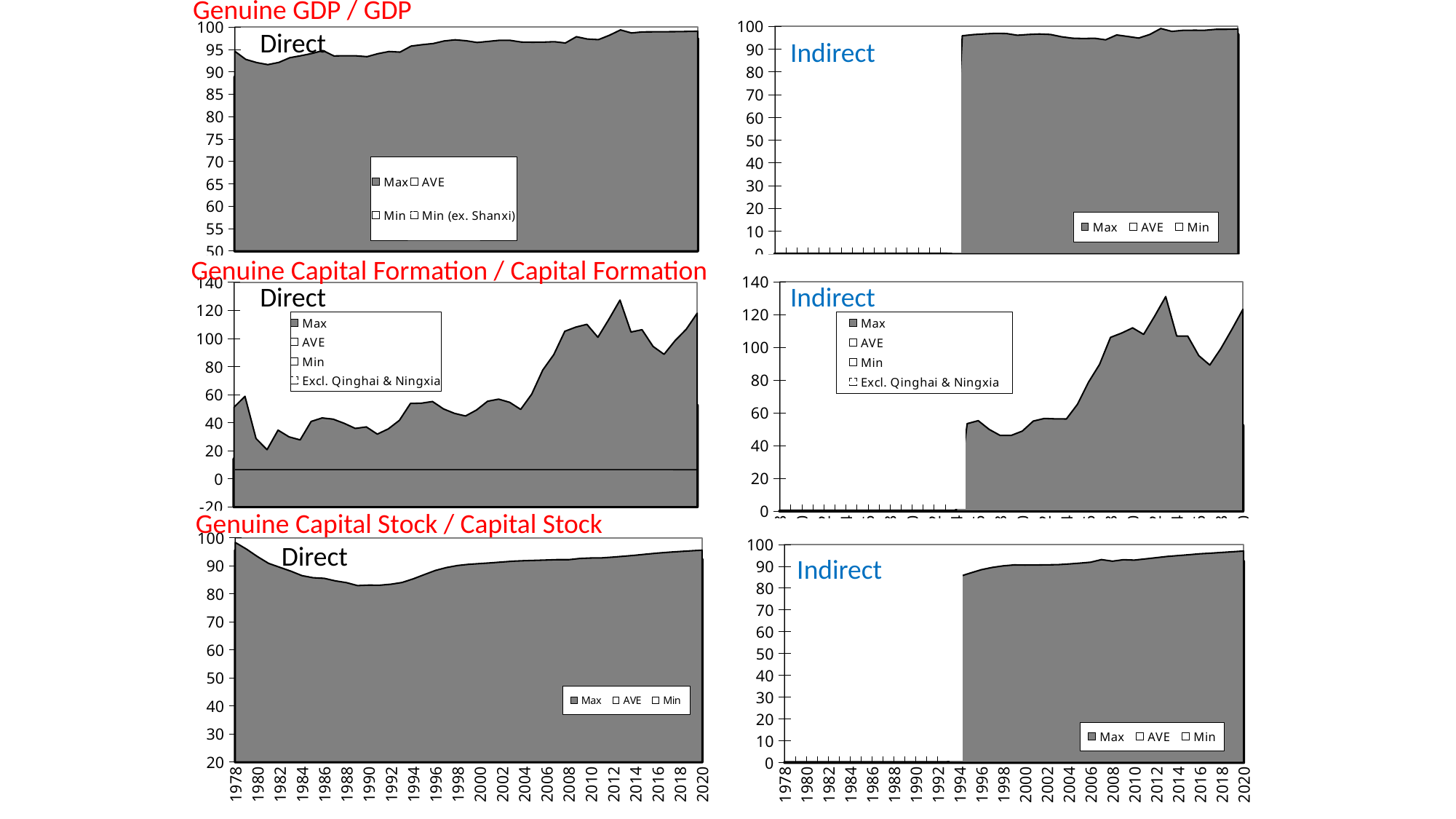
In the 'Genuine Capital Formation / Capital Formation' Indirect chart (middle right), is the value for 2013 greater or less than 120? greater Which legend entry appears in the 'Genuine GDP / GDP' Direct chart (top left) but not in its Indirect counterpart? Min (ex. Shanxi) In the 'Genuine Capital Stock / Capital Stock' Direct chart (bottom left), do the values rise or fall from 1978 to 1990? fall In the 'Genuine Capital Stock / Capital Stock' Direct chart (bottom left), is the value for 1990 greater or less than 90? less How many series does the legend of the 'Genuine GDP / GDP' Direct chart (top left) list? 4 What kind of chart is the 'Genuine Capital Stock / Capital Stock' Direct chart (bottom left)? Area chart In the 'Genuine Capital Stock / Capital Stock' Direct chart (bottom left), is the value for 1978 greater or less than 90? greater In the 'Genuine Capital Stock / Capital Stock' Indirect chart (bottom right), do the values rise or fall from 1996 to 2020? rise How many series does the legend of the 'Genuine Capital Stock / Capital Stock' Indirect chart (bottom right) list? 3